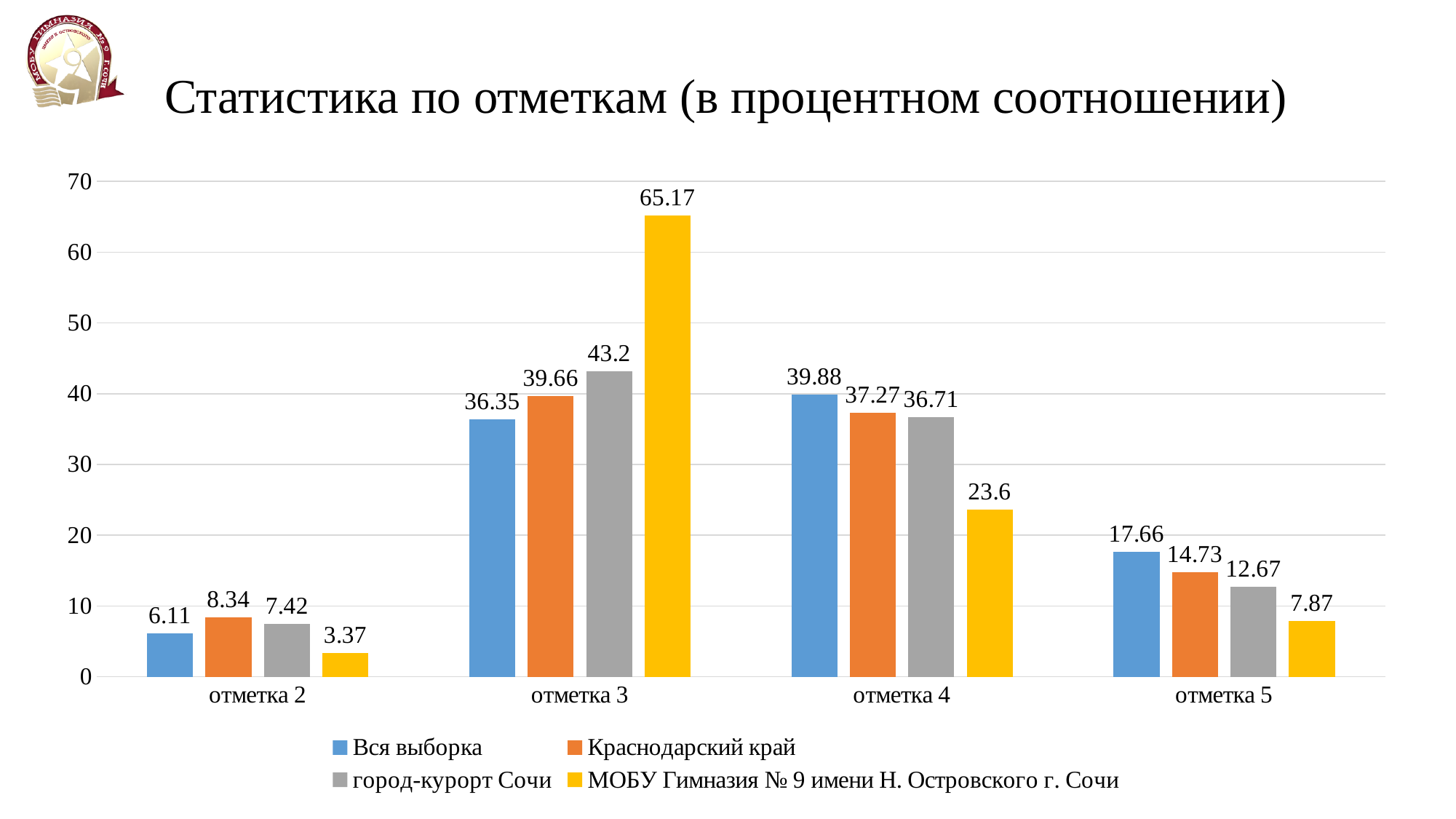
What is the value for МОБУ Гимназия № 9 имени Н. Островского г. Сочи at отметка 3? 65.17 What is the value for Краснодарский край at отметка 5? 14.73 How many categories are shown on the x axis? 4 How many series does the legend list? 4 What is the value for Вся выборка at отметка 4? 39.88 At отметка 4, which is larger: Вся выборка or МОБУ Гимназия № 9 имени Н. Островского г. Сочи? Вся выборка What is the difference between the МОБУ Гимназия № 9 value and the город-курорт Сочи value at отметка 3? 21.97 Which category has the highest value for the МОБУ Гимназия № 9 имени Н. Островского г. Сочи series? отметка 3 What is the title of the slide? Статистика по отметкам (в процентном соотношении) What is the value for город-курорт Сочи at отметка 2? 7.42 Which category has the lowest value for the Вся выборка series? отметка 2 What kind of chart is shown on the slide? Bar chart